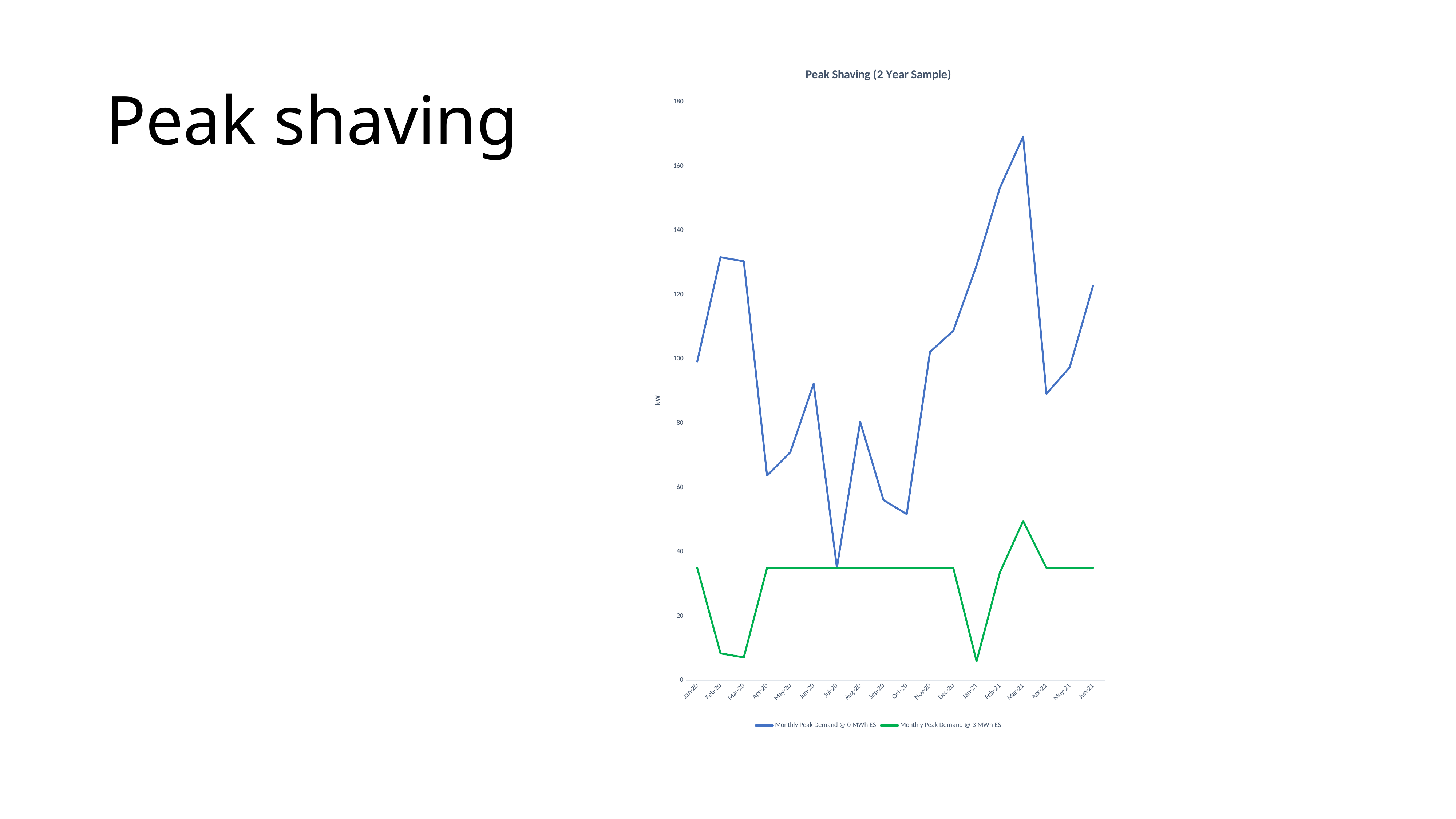
In which month does the Monthly Peak Demand @ 0 MWh ES series reach its highest value? Mar-21 What is the title of the chart? Peak Shaving (2 Year Sample) Is the value for Monthly Peak Demand @ 0 MWh ES in Mar-21 greater or less than 160? greater In which month does the Monthly Peak Demand @ 0 MWh ES series reach its lowest value? Jul-20 Does the Monthly Peak Demand @ 0 MWh ES series rise or fall from Apr-21 to Jun-21? rise Which is larger for Monthly Peak Demand @ 0 MWh ES: the value in Feb-20 or the value in Apr-20? Feb-20 Is the value for Monthly Peak Demand @ 3 MWh ES in Feb-20 greater or less than 20? less In which month does the Monthly Peak Demand @ 3 MWh ES series reach its highest value? Mar-21 Is the value for Monthly Peak Demand @ 0 MWh ES in Jul-20 greater or less than 40? less What kind of chart is shown on the slide? line chart How many months are plotted along the x axis? 18 How many series does the legend list? 2